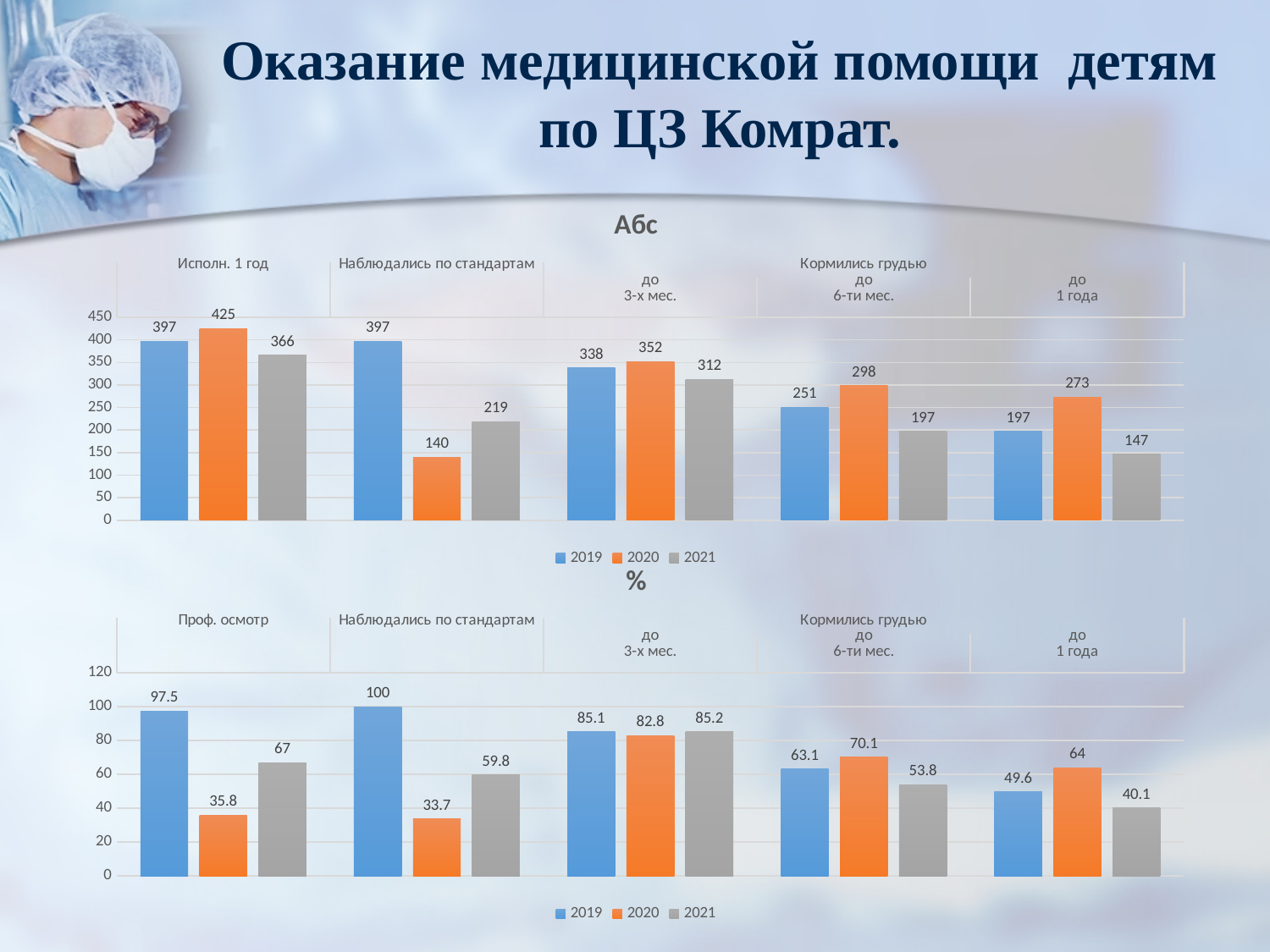
In the top chart titled 'Абс', what is the value for 2021 in the 'Наблюдались по стандартам' category? 219 In the bottom chart titled '%', what is the value for 2019 in the 'Проф. осмотр' category? 97.5 In the bottom chart titled '%', which year has the highest value in the 'Наблюдались по стандартам' category? 2019 In the bottom chart titled '%', how many categories are shown along the x axis? 5 In the top chart titled 'Абс', what is the difference between the 2019 and 2021 values for 'Кормились грудью до 1 года'? 50 In the bottom chart titled '%', what colour are the bars for the 2021 series? Grey What kind of chart is the bottom chart titled '%'? Bar chart In the bottom chart titled '%', what is the difference between the 2020 and 2021 values for 'Кормились грудью до 1 года'? 23.9 In the top chart titled 'Абс', which year has the lowest value in the 'Наблюдались по стандартам' category? 2020 In the top chart titled 'Абс', which is larger: the 2020 value for 'Кормились грудью до 6-ти мес.' or the 2020 value for 'Кормились грудью до 1 года'? Кормились грудью до 6-ти мес. (298) How many series does the legend of the top chart titled 'Абс' list? 3 In the top chart titled 'Абс', what is the value for 2020 in the 'Исполн. 1 год' category? 425